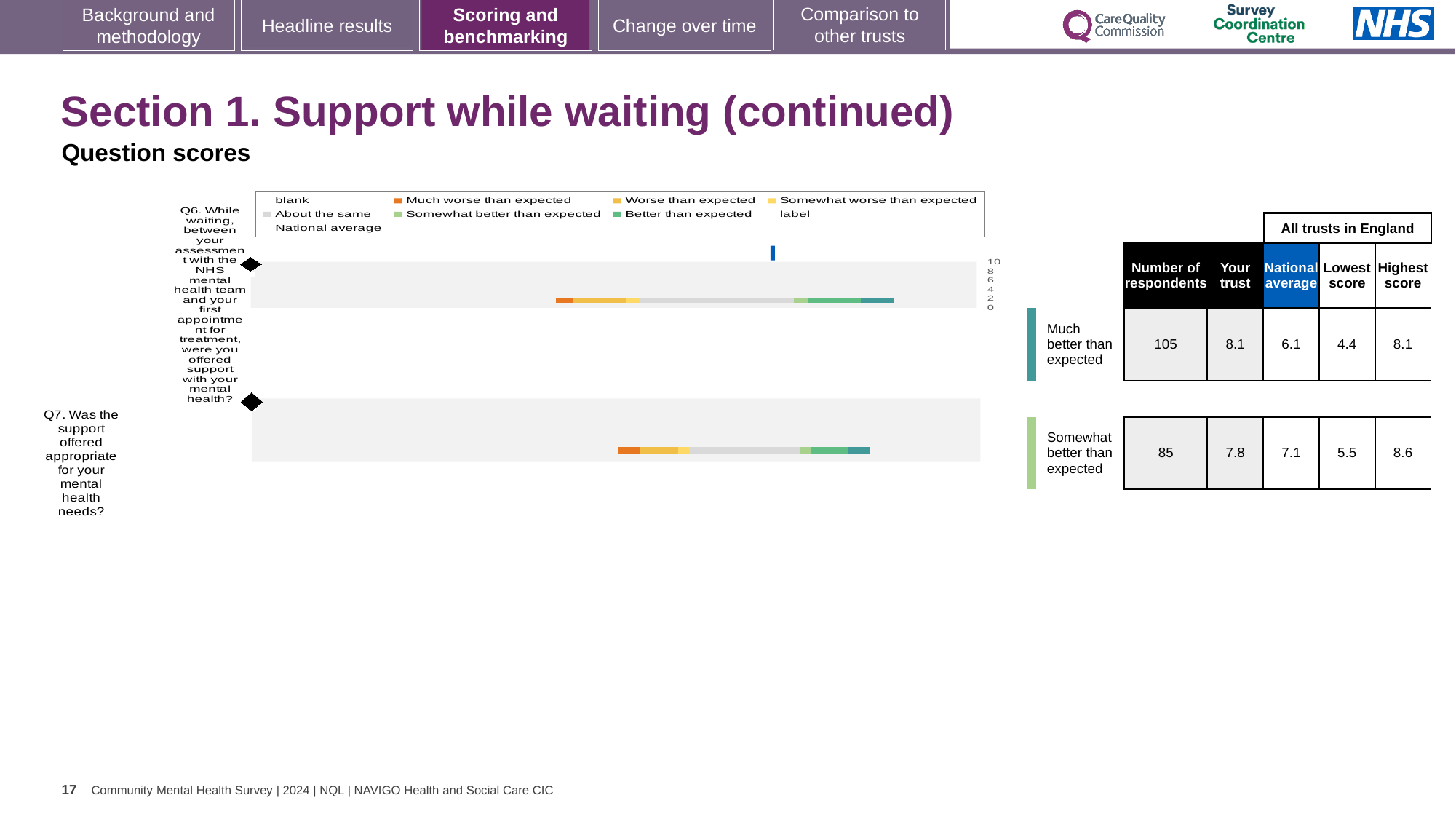
Which question has the higher 'Your trust' score in the table beside the chart, Q6 or Q7? Q6 Which legend entry is shown in orange in the chart? Much worse than expected According to the table beside the chart, what is the 'Your trust' score for Q6? 8.1 What is the highest tick value shown on the chart's axis? 10 According to the table beside the chart, what is the national average for Q7? 7.1 According to the table beside the chart, what is the lowest score across all trusts in England for Q7? 5.5 How many entries does the chart's legend list? 9 How many questions (categories) are plotted in the chart? 2 What kind of chart is shown on the slide? bar chart According to the table beside the chart, how many respondents answered Q6? 105 What benchmark category is Q7 assigned to, as labelled beside the chart? Somewhat better than expected What is the difference between the 'Your trust' score and the national average for Q6 in the table beside the chart? 2.0